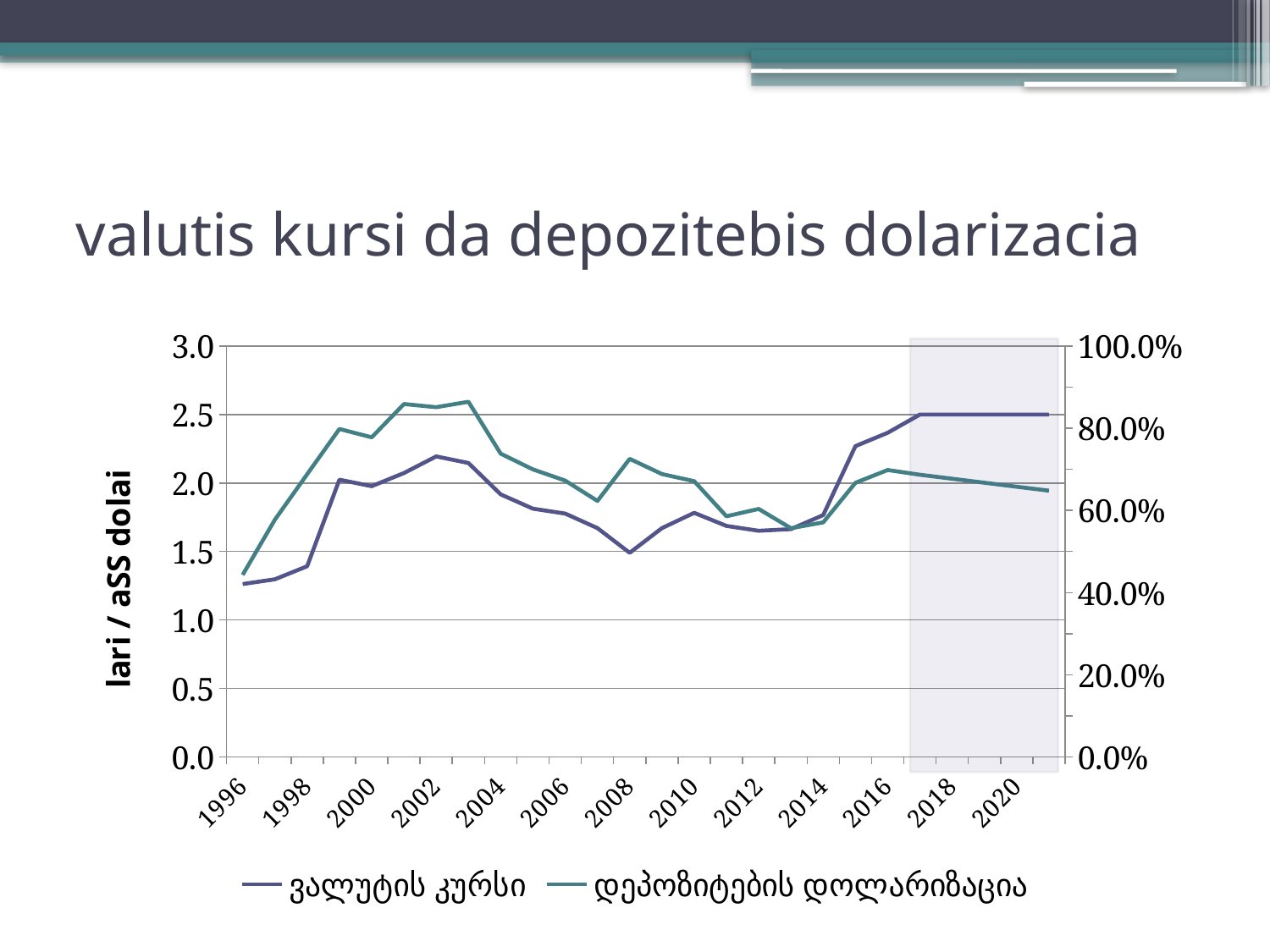
Is the value of the ვალუტის კურსი series in 1996 greater or less than 1.5 on the left axis? less Is the value of the დეპოზიტების დოლარიზაცია series in 2020 greater or less than 80.0% on the right axis? less Is the value of the ვალუტის კურსი series in 2018 greater or less than 2.0 on the left axis? greater What is the label on the left vertical axis of the chart? lari / aSS dolai How many series does the legend list? 2 What is the title of the slide above the chart? valutis kursi da depozitebis dolarizacia Does the დეპოზიტების დოლარიზაცია series rise or fall between 2003 and 2007? fall What kind of chart is shown on the slide? line chart Which year has the higher value for the ვალუტის კურსი series, 2002 or 2008? 2002 How many year labels are shown along the x axis? 13 Does the ვალუტის კურსი series rise or fall between 2014 and 2017? rise